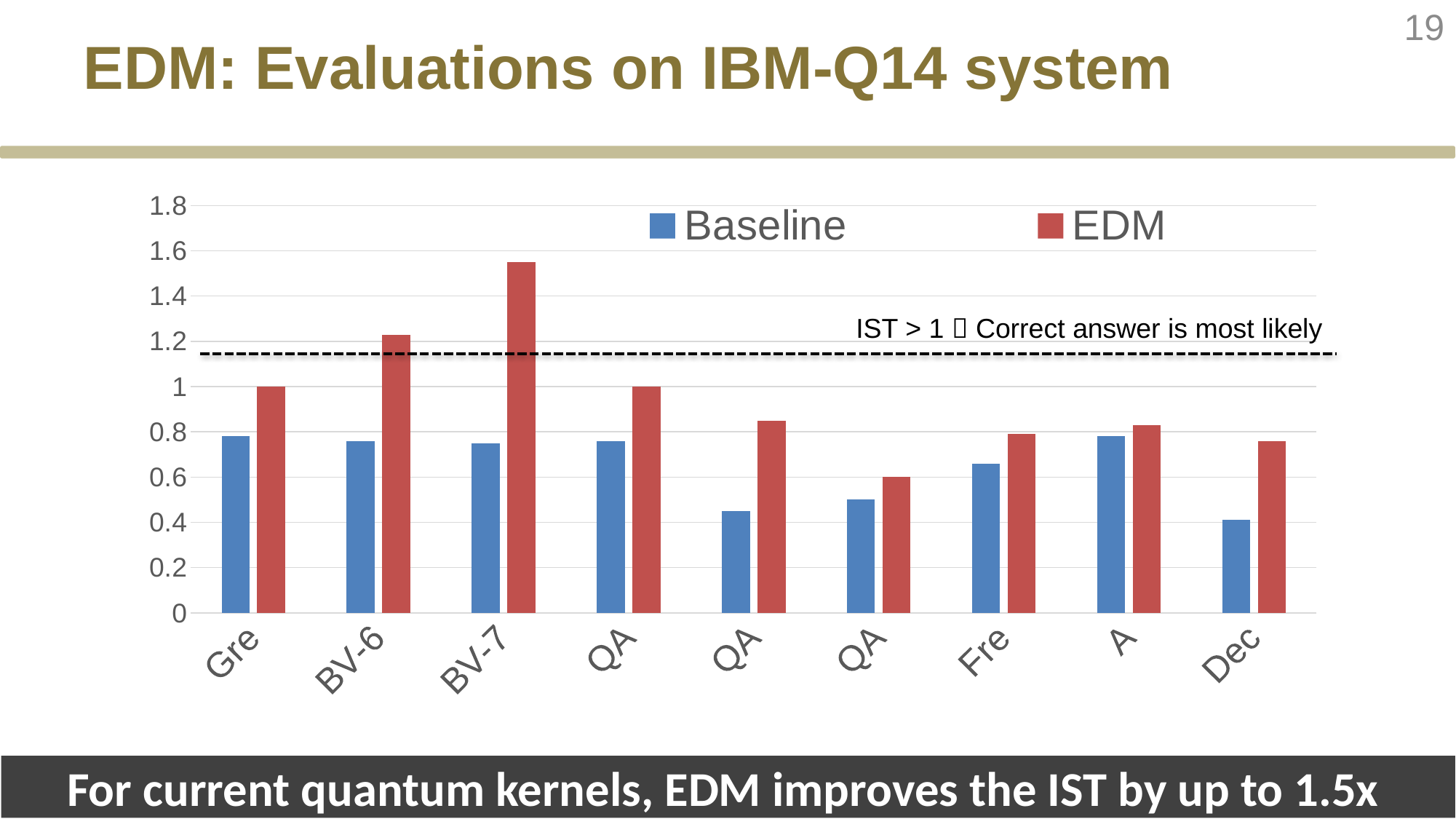
How many categories are shown along the x axis? 9 How many series does the legend list? 2 Which category has the highest EDM value? BV-7 Is the Baseline value for Dec greater or less than 0.6? less For Dec, which series has the larger value, Baseline or EDM? EDM Which is larger, the EDM value for BV-7 or the EDM value for BV-6? BV-7 Is the Baseline value for Gre greater or less than 0.6? greater Is the EDM value for BV-6 greater or less than 1? greater What are the two series names shown in the legend? Baseline and EDM What kind of chart is shown on the slide? bar chart